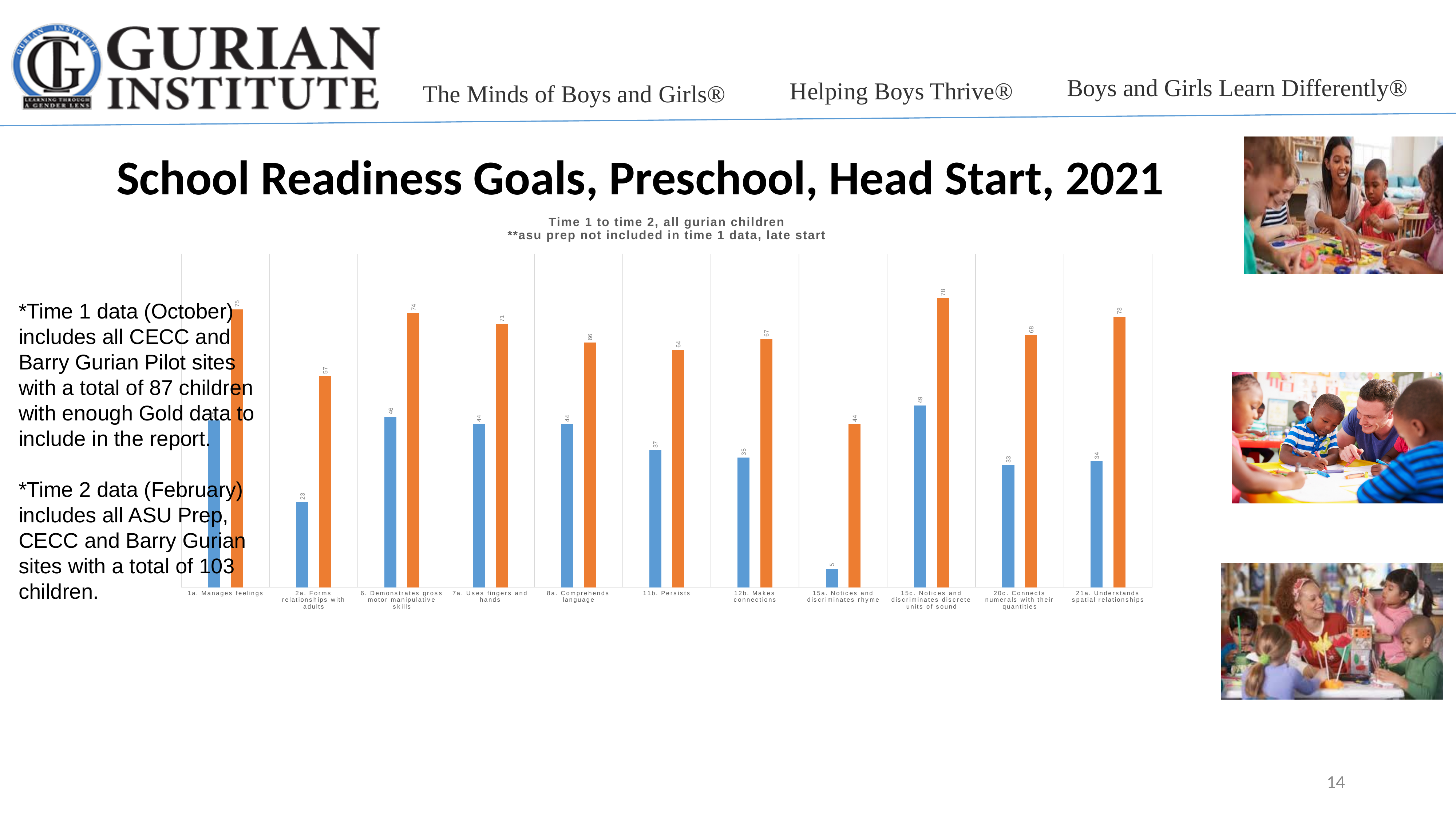
What is the value of the blue bar for '2a. Forms relationships with adults'? 23 Which category has the highest orange bar? 15c. Notices and discriminates discrete units of sound Which category has the lowest blue bar? 15a. Notices and discriminates rhyme What is the value of the blue bar for '11b. Persists'? 37 How many categories are shown on the x axis of the chart? 11 What is the value of the orange bar for '15a. Notices and discriminates rhyme'? 44 What type of chart is shown on the slide? bar chart Which is larger: the orange bar for '7a. Uses fingers and hands' or the orange bar for '8a. Comprehends language'? 7a. Uses fingers and hands What is the value of the orange bar for '6. Demonstrates gross motor manipulative skills'? 74 What is the first line of the chart's title? Time 1 to time 2, all gurian children What is the difference between the orange and blue bars for '12b. Makes connections'? 32 What is the difference between the orange and blue bars for '20c. Connects numerals with their quantities'? 35